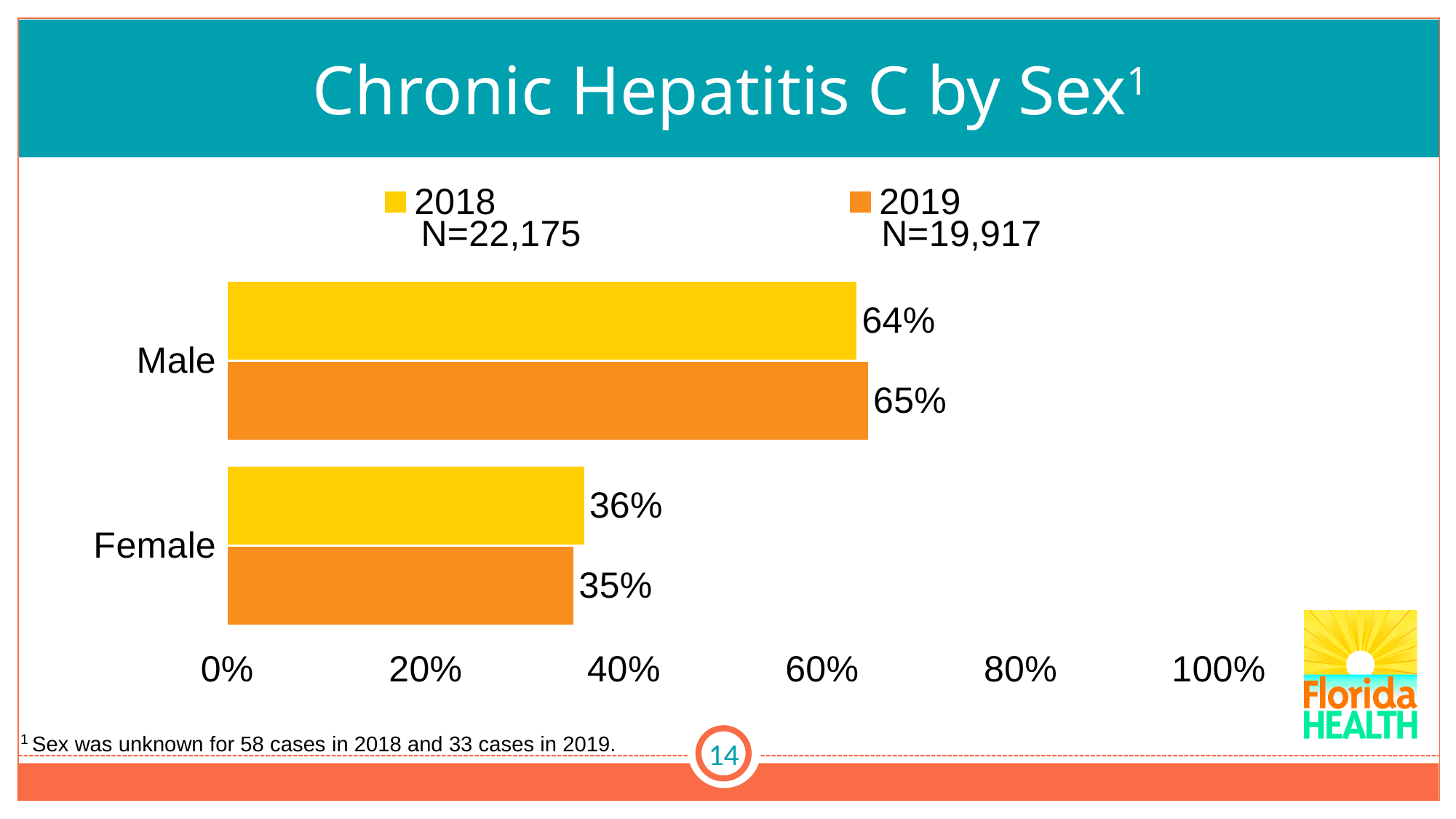
What is the difference between the male and female percentages in 2019? 30% How many sex categories are shown on the chart? 2 What is the difference between the male and female percentages in 2018? 28% What percentage of chronic hepatitis C cases were male in 2018? 64% Which sex had the higher share of chronic hepatitis C cases in 2019? Male What percentage of chronic hepatitis C cases were female in 2019? 35% What kind of chart is shown on the slide? Bar chart What percentage of chronic hepatitis C cases were male in 2019? 65% What is the total number of cases (N) for 2018 shown in the legend? N=22,175 What percentage of chronic hepatitis C cases were female in 2018? 36% Which sex had the lower share of chronic hepatitis C cases in 2018? Female How many series does the legend list? 2